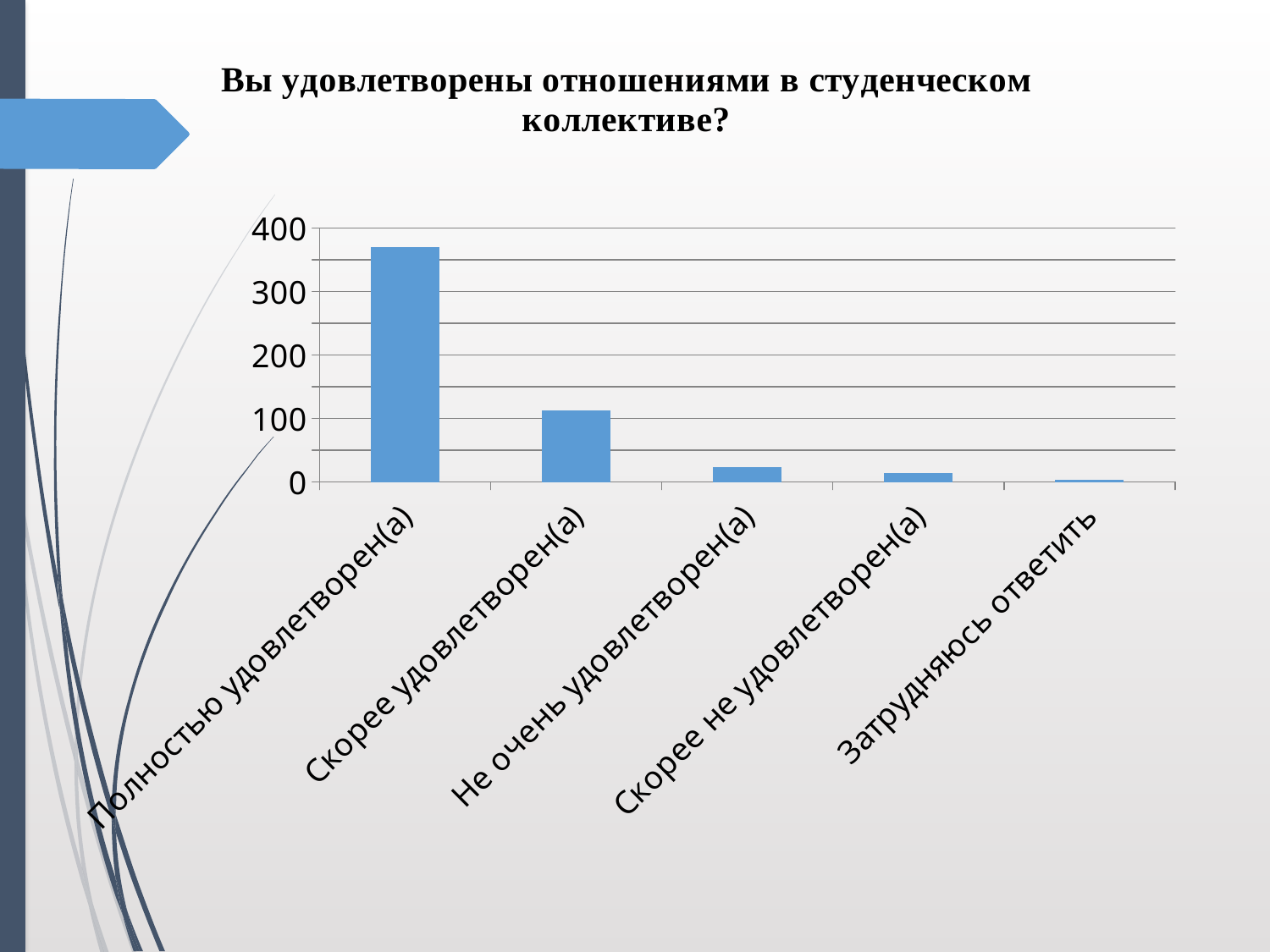
Which category has the highest value? Полностью удовлетворен(а) Which category has the lowest value? Затрудняюсь ответить Is the value for Скорее удовлетворен(а) greater or less than 200? less What is the title of the chart? Вы удовлетворены отношениями в студенческом коллективе? How many categories are shown on the x axis of the chart? 5 What kind of chart is shown on the slide? bar chart Which is larger, the value for Скорее удовлетворен(а) or the value for Не очень удовлетворен(а)? Скорее удовлетворен(а) Is the value for Скорее удовлетворен(а) greater or less than 100? greater Is the value for Полностью удовлетворен(а) greater or less than 300? greater Do the values rise or fall from left to right along the x axis? fall Which is larger, the value for Скорее не удовлетворен(а) or the value for Затрудняюсь ответить? Скорее не удовлетворен(а)